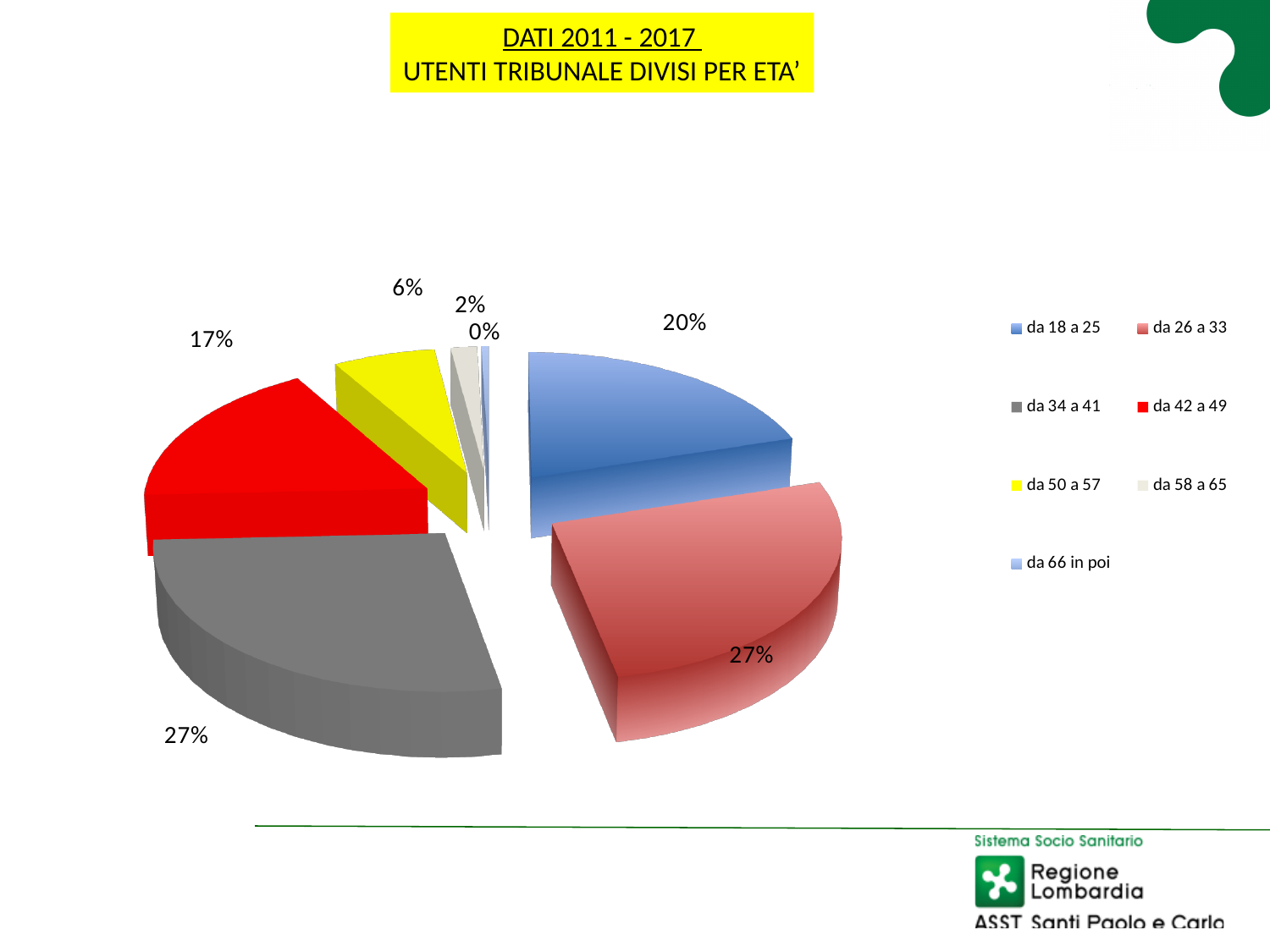
What is the title of the slide above the chart? DATI 2011 - 2017 UTENTI TRIBUNALE DIVISI PER ETA' What percentage is shown for the 'da 34 a 41' slice? 27% What is the difference in percentage points between the 'da 26 a 33' slice and the 'da 42 a 49' slice? 10 percentage points What share of the pie does the 'da 18 a 25' slice represent? 20% Which age group has the smallest share of the pie? da 66 in poi What colour is the 'da 50 a 57' slice? Yellow What percentage is shown for the 'da 50 a 57' slice? 6% What percentage is shown for the 'da 42 a 49' slice? 17% Which is larger, the share for 'da 18 a 25' or the share for 'da 42 a 49'? da 18 a 25 How many age groups are listed in the legend? 7 What kind of chart is shown on the slide? Pie chart What percentage is shown for the 'da 58 a 65' slice? 2%